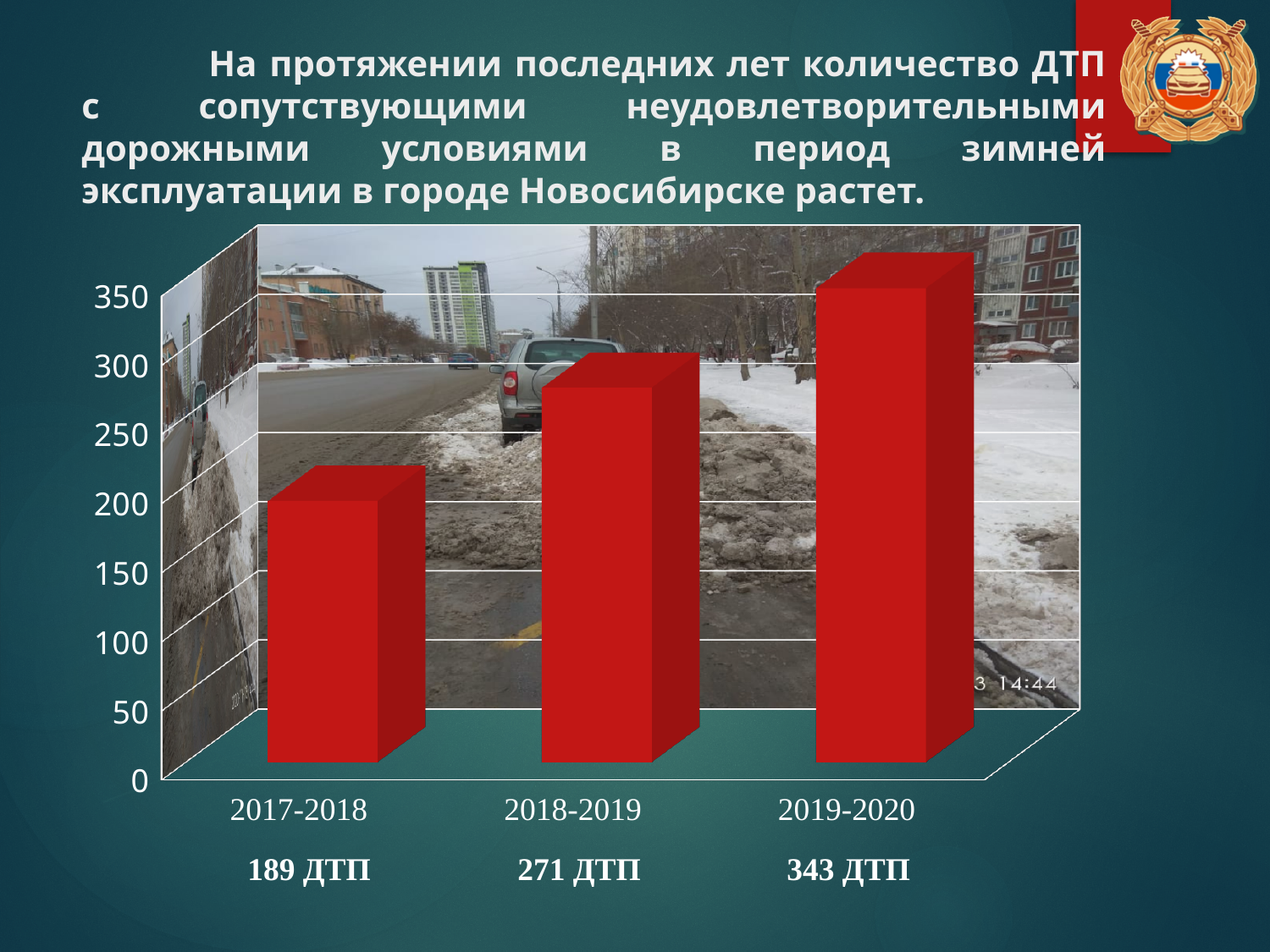
What is the difference in accidents between 2018-2019 and 2017-2018? 82 Which period has the lowest number of accidents? 2017-2018 Do the values rise or fall from 2017-2018 to 2019-2020? rise What is the number of accidents (ДТП) for 2017-2018? 189 ДТП What type of chart is shown on the slide? bar chart How many periods are shown on the chart? 3 What is the number of accidents (ДТП) for 2018-2019? 271 ДТП What is the difference in accidents between 2019-2020 and 2017-2018? 154 What is the number of accidents (ДТП) for 2019-2020? 343 ДТП Which period has more accidents, 2018-2019 or 2019-2020? 2019-2020 Is the value for 2018-2019 greater or less than 250? greater Which period has the highest number of accidents? 2019-2020